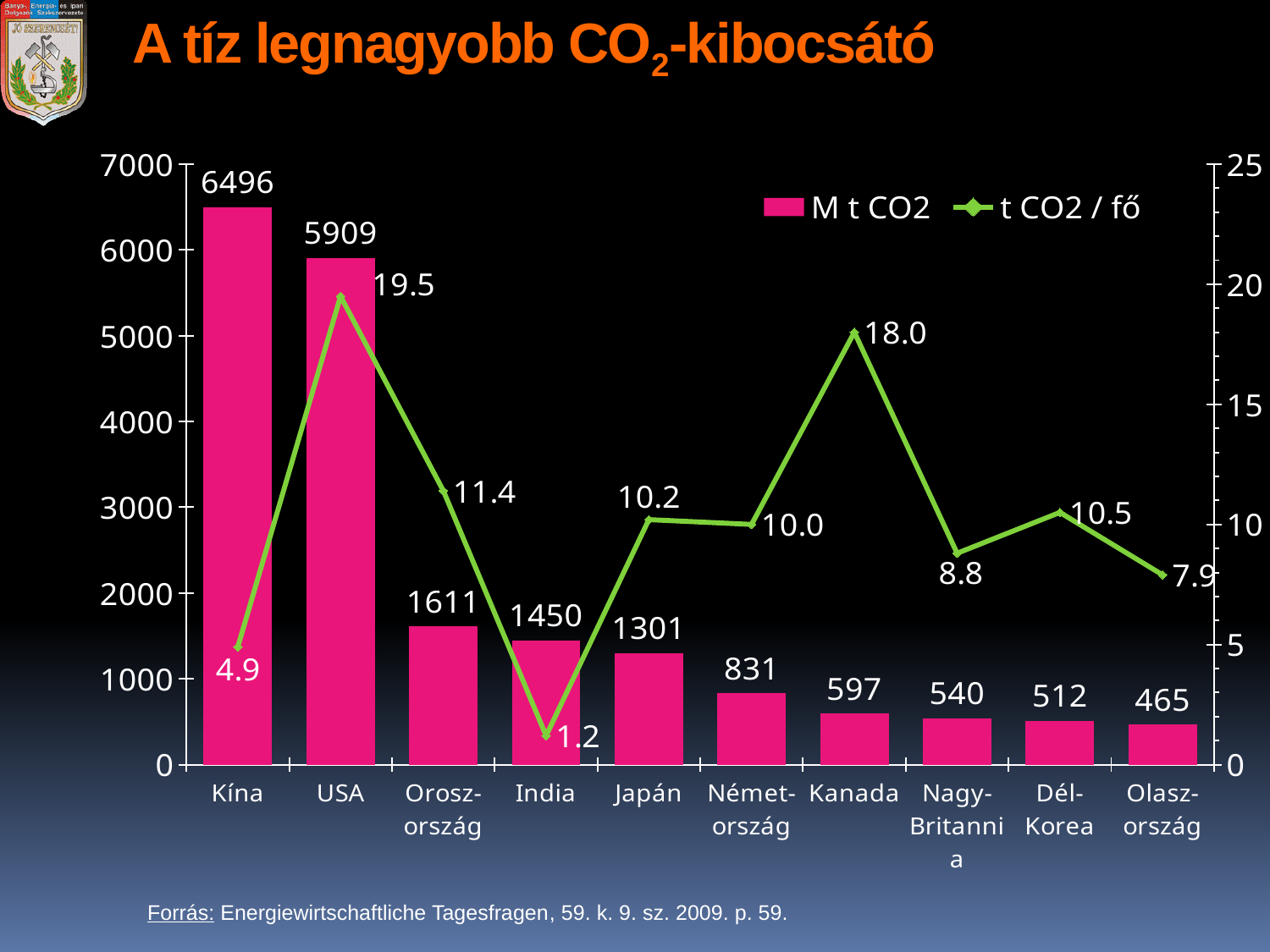
Do the M t CO2 bar values rise or fall from Kína to Olaszország? Fall Which has a higher t CO2 / fő value, Kanada or Oroszország? Kanada What is the t CO2 / fő value for USA? 19.5 How many series does the legend list? 2 What is the M t CO2 value for Kína? 6496 Which country has the lowest t CO2 / fő value? India What kind of chart is used for the M t CO2 series? Bar chart What is the M t CO2 value for Németország? 831 What is the difference in M t CO2 between Kína and USA? 587 How many countries are shown on the chart? 10 Which country has the highest t CO2 / fő value? USA Which country has the lowest M t CO2 value? Olaszország